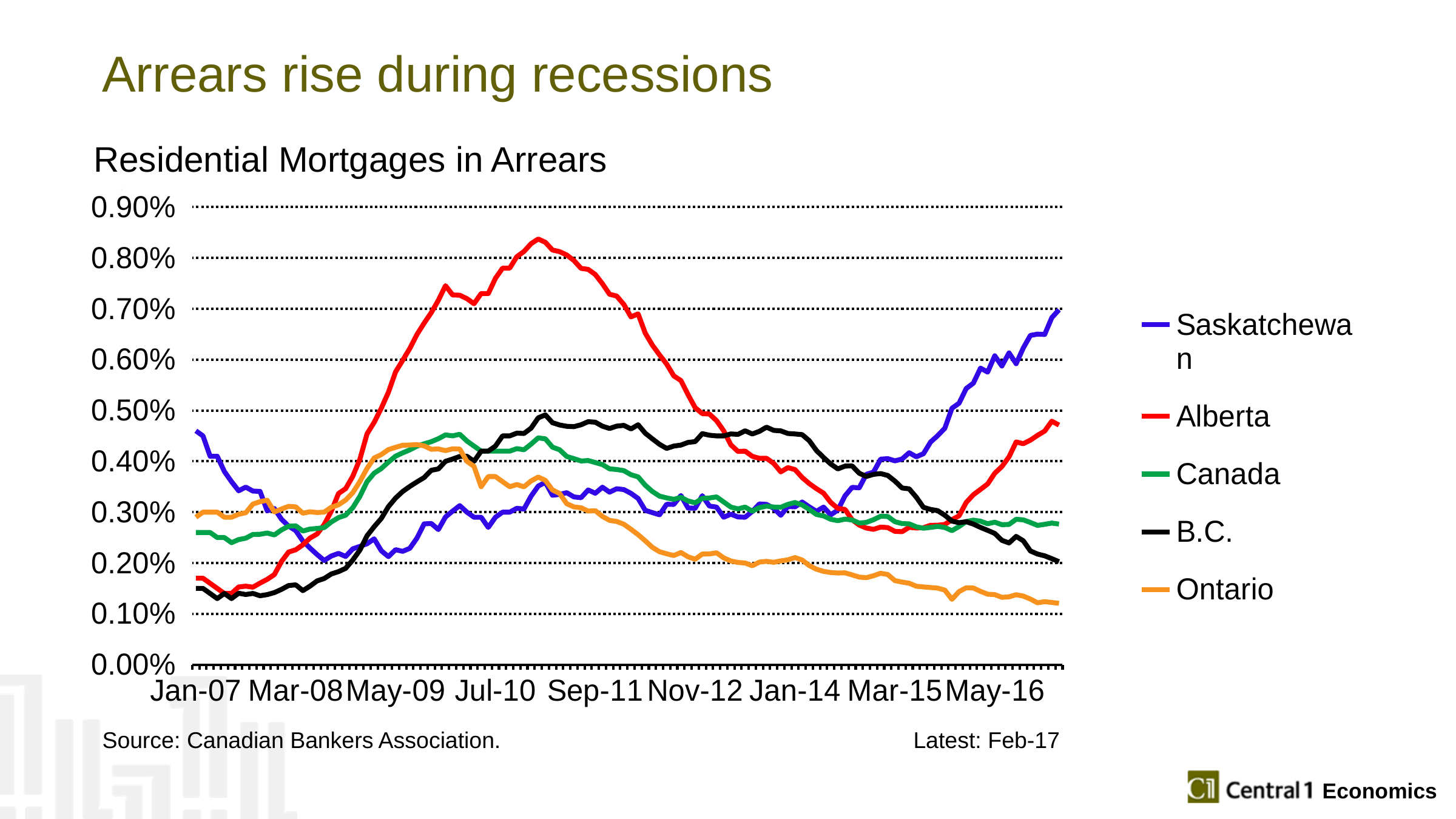
Which series has the lowest value at the right end of the chart? Ontario Is the peak value for Alberta greater or less than 0.80%? greater Is the peak value for Ontario greater or less than 0.40%? greater Which series reaches the highest value on the chart? Alberta At the right end of the chart, which is larger: Saskatchewan or Ontario? Saskatchewan What is the title of the chart? Residential Mortgages in Arrears How many series does the legend list? 5 Does the Ontario line rise or fall from Jan-14 to the end of the chart? fall Does the Saskatchewan line rise or fall from Mar-15 to the end of the chart? rise Is the value for Ontario at the end of the series (May-16 onward) greater or less than 0.20%? less What kind of chart is shown on the slide? line chart